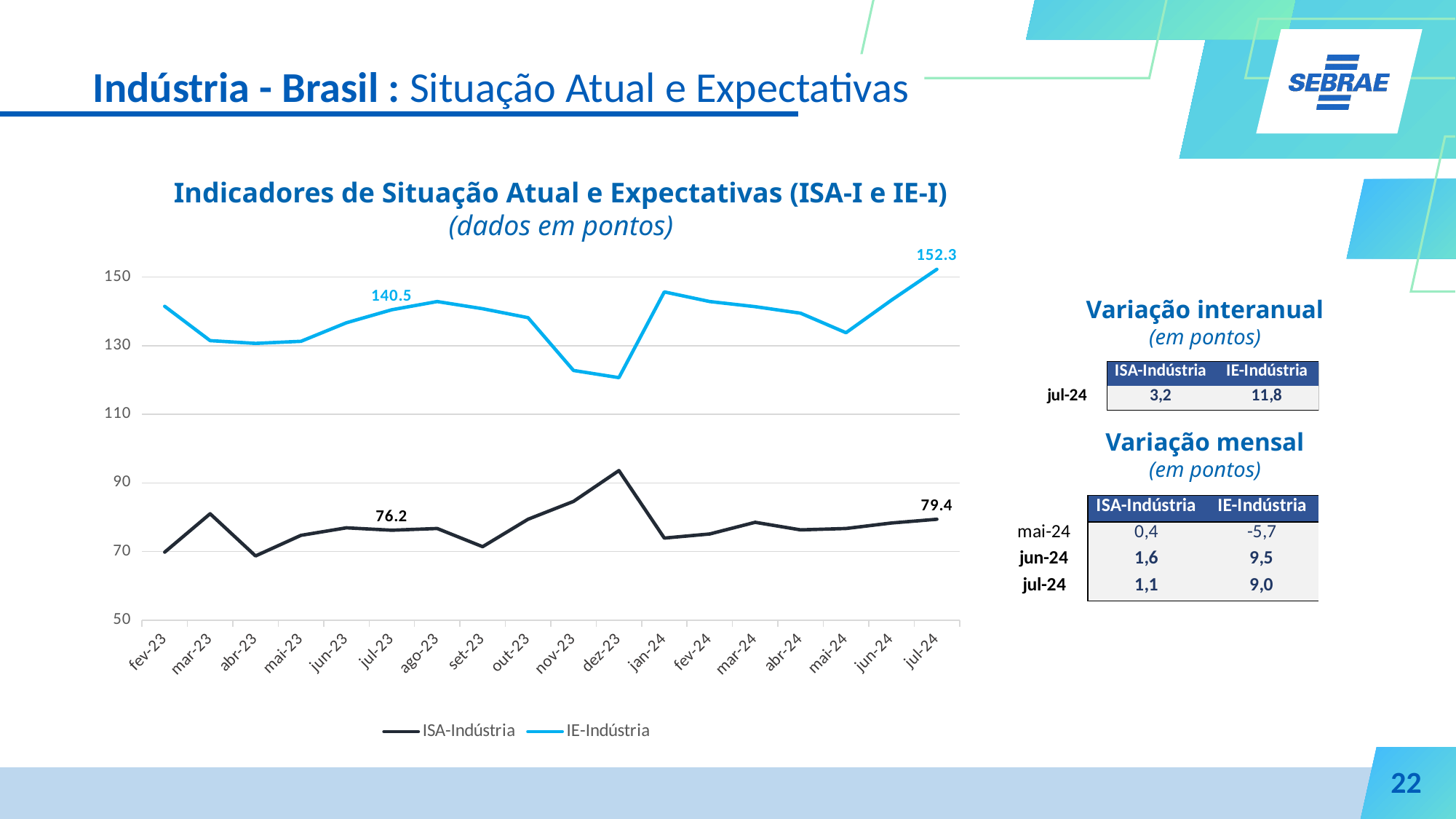
What is the value of ISA-Indústria in jul-24? 79.4 How many months are plotted on the x axis of the chart? 18 How many series does the chart legend list? 2 What is the value of ISA-Indústria in jul-23? 76.2 In which month does IE-Indústria reach its highest value? jul-24 Is the value for ISA-Indústria in dez-23 greater or less than 90? greater In jul-24, which series has the higher value, ISA-Indústria or IE-Indústria? IE-Indústria What is the value of IE-Indústria in jul-23? 140.5 What is the value of IE-Indústria in jul-24? 152.3 By how many points did IE-Indústria change from jul-23 to jul-24? 11.8 Is the value for IE-Indústria in dez-23 greater or less than 130? less By how many points did ISA-Indústria change from jul-23 to jul-24? 3.2